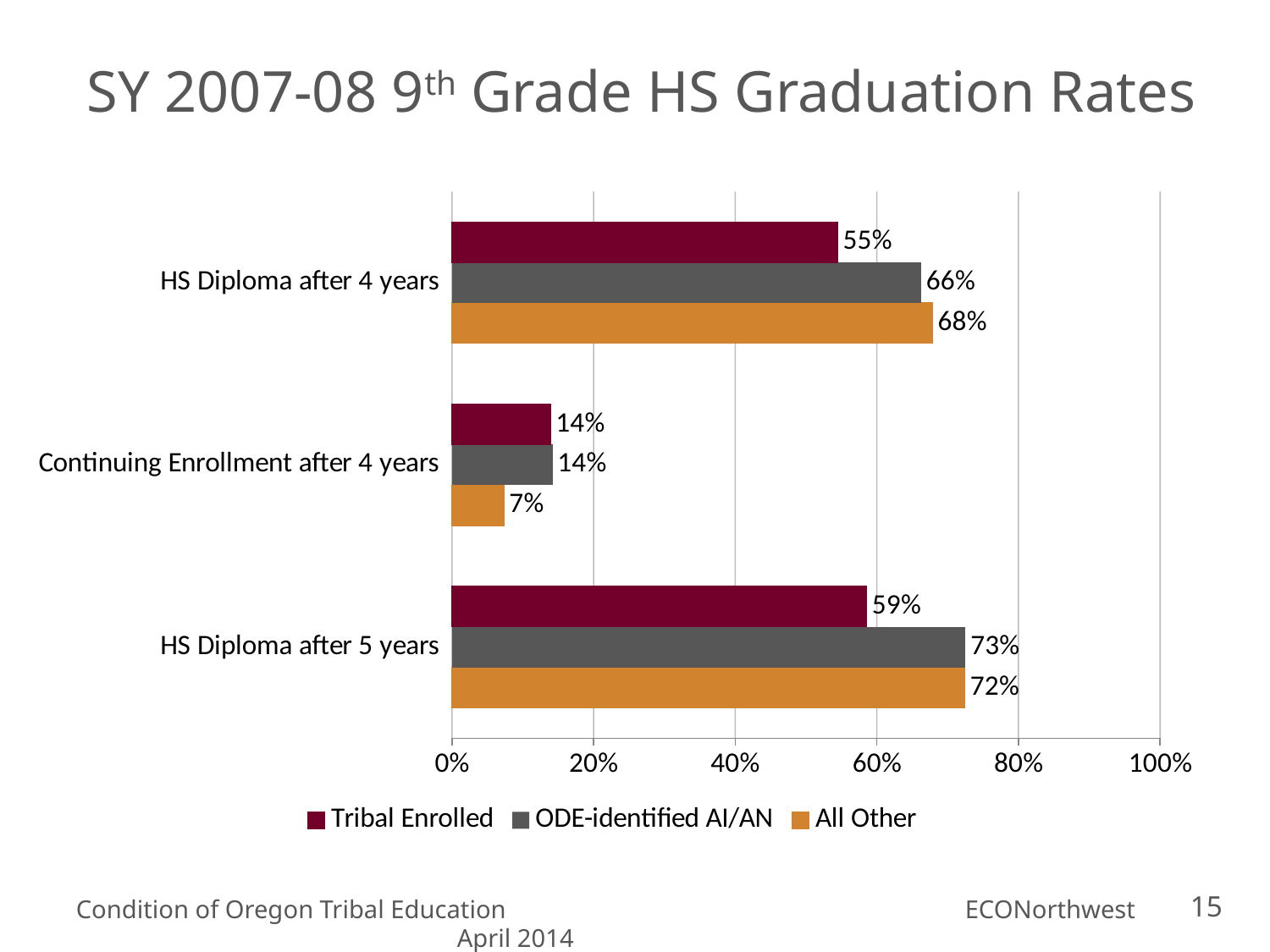
How many categories are shown on the chart? 3 Which is larger for Tribal Enrolled students: HS Diploma after 4 years or HS Diploma after 5 years? HS Diploma after 5 years What kind of chart is shown on the slide? Bar chart Which series has the lowest Continuing Enrollment after 4 years rate? All Other Which series has the highest HS Diploma after 4 years rate? All Other What is the HS Diploma after 5 years rate for ODE-identified AI/AN students? 73% What is the difference between the All Other and Tribal Enrolled HS Diploma after 5 years rates? 13% Is the Tribal Enrolled HS Diploma after 5 years rate greater or less than 60%? less What is the Continuing Enrollment after 4 years rate for All Other students? 7% How many series does the legend list? 3 What is the HS Diploma after 4 years rate for Tribal Enrolled students? 55% What is the title of the chart on the slide? SY 2007-08 9th Grade HS Graduation Rates